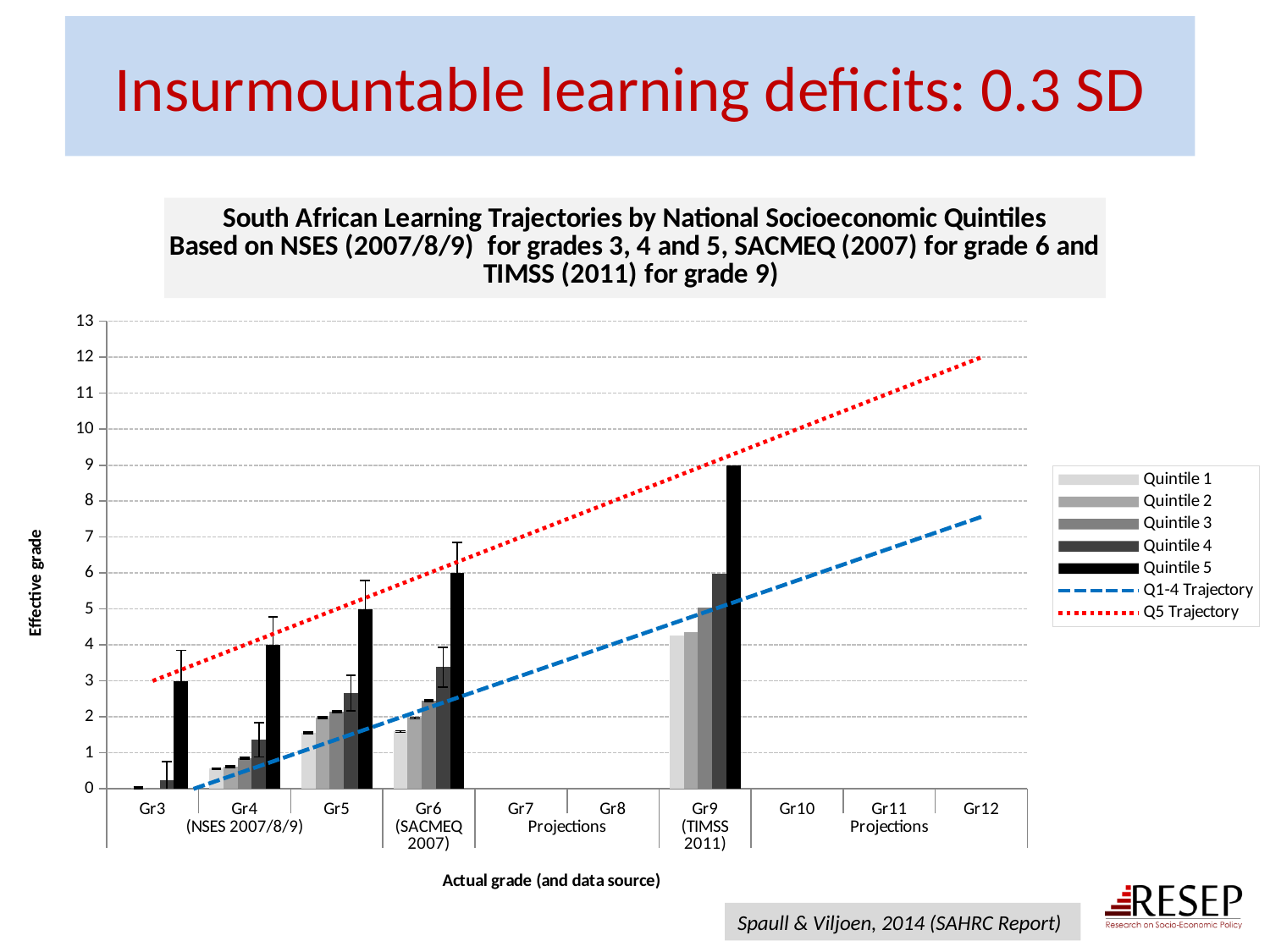
What is the effective grade for Quintile 5 at Gr3? 3 What kind of chart is shown on the slide? Combination bar and line chart What is the effective grade for Quintile 5 at Gr6 (SACMEQ 2007)? 6 Is the effective grade for Quintile 4 at Gr5 greater or less than 3? less Is the effective grade for Quintile 1 at Gr9 greater or less than 4? greater Which legend entry is drawn as a red dotted line? Q5 Trajectory Which quintile has the lowest effective grade at Gr4? Quintile 1 What is the effective grade for Quintile 5 at Gr9 (TIMSS 2011)? 9 Does the effective grade for Quintile 5 rise or fall from Gr3 to Gr9? rise How many series does the legend list? 7 Which quintile has the highest effective grade at Gr9? Quintile 5 How many grade categories are shown on the x axis? 10